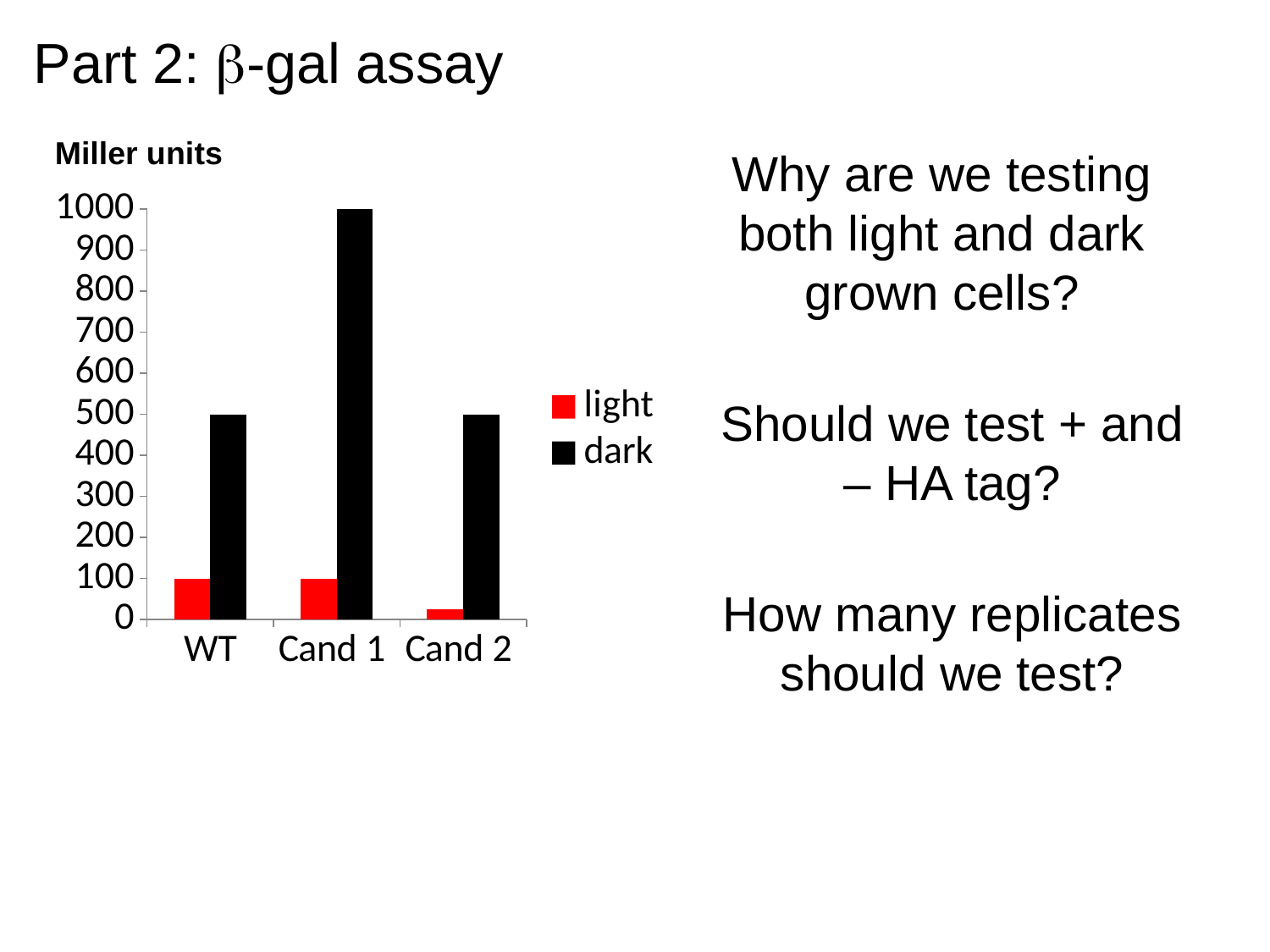
How many categories are shown on the x axis of the chart? 3 What kind of chart is shown on the slide? bar chart What is the dark value for WT? 500 What is the difference between the dark value for Cand 1 and the dark value for WT? 500 Which category has the lowest light value? Cand 2 What is the light value for WT? 100 Which category has the highest dark value? Cand 1 How many series does the chart's legend list? 2 What colour represents the light series in the chart? red Is the light value for Cand 2 greater or less than 100? less What is the dark value for Cand 1? 1000 Which is larger, the dark value for Cand 1 or the dark value for Cand 2? Cand 1